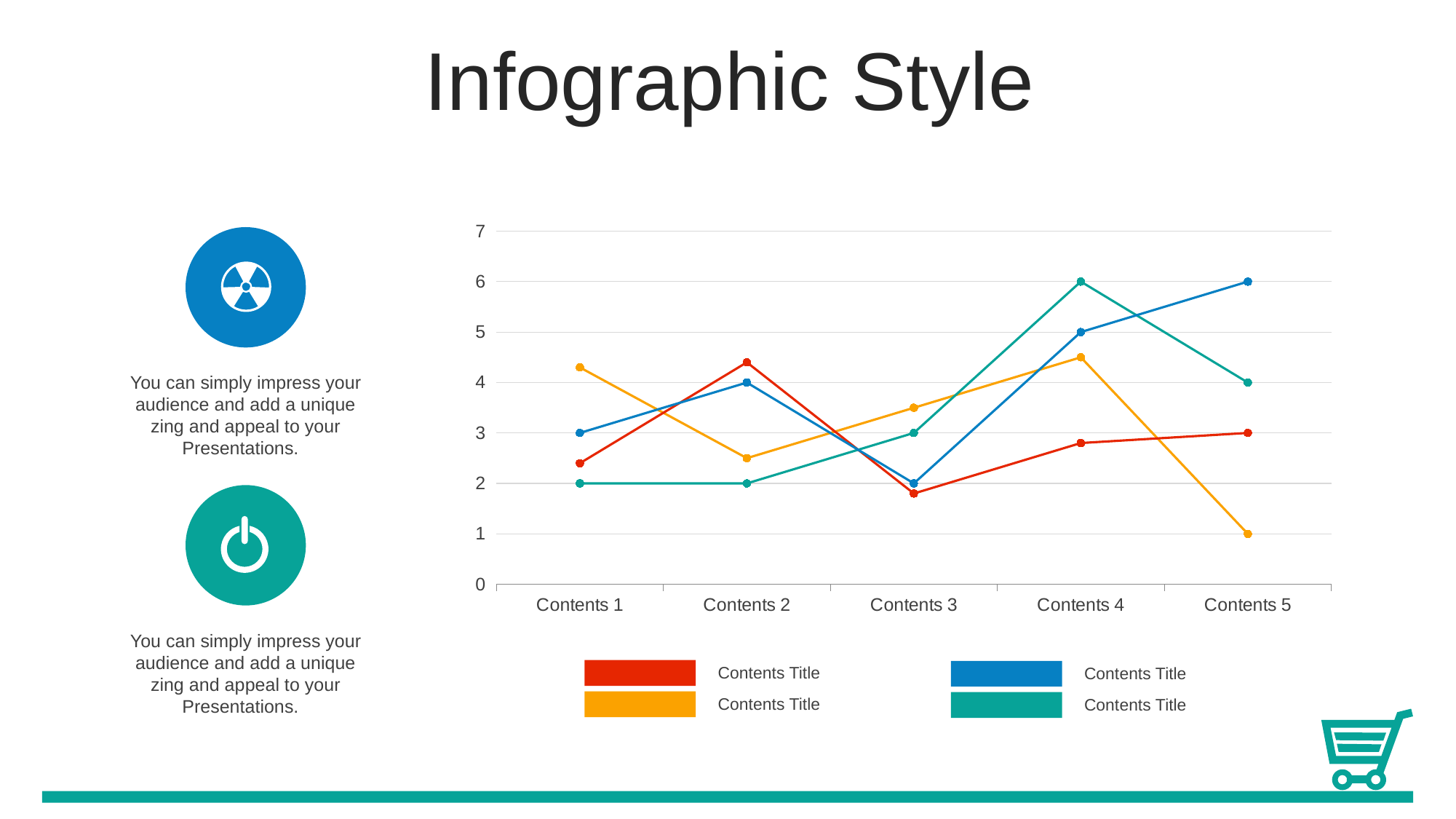
How many series does the chart's legend list? 4 Which is larger at Contents 4: the teal line or the red line? the teal line Does the blue line rise or fall from Contents 3 to Contents 5? rise What is the value of the blue line at Contents 1? 3 What kind of chart is shown on the slide? line chart What is the value of the blue line at Contents 5? 6 What is the value of the orange line at Contents 5? 1 At which category does the blue line reach its highest value? Contents 5 What is the value of the teal line at Contents 4? 6 How many categories are shown on the x axis of the chart? 5 Is the value of the red line at Contents 2 greater or less than 4? greater At which category does the orange line reach its lowest value? Contents 5